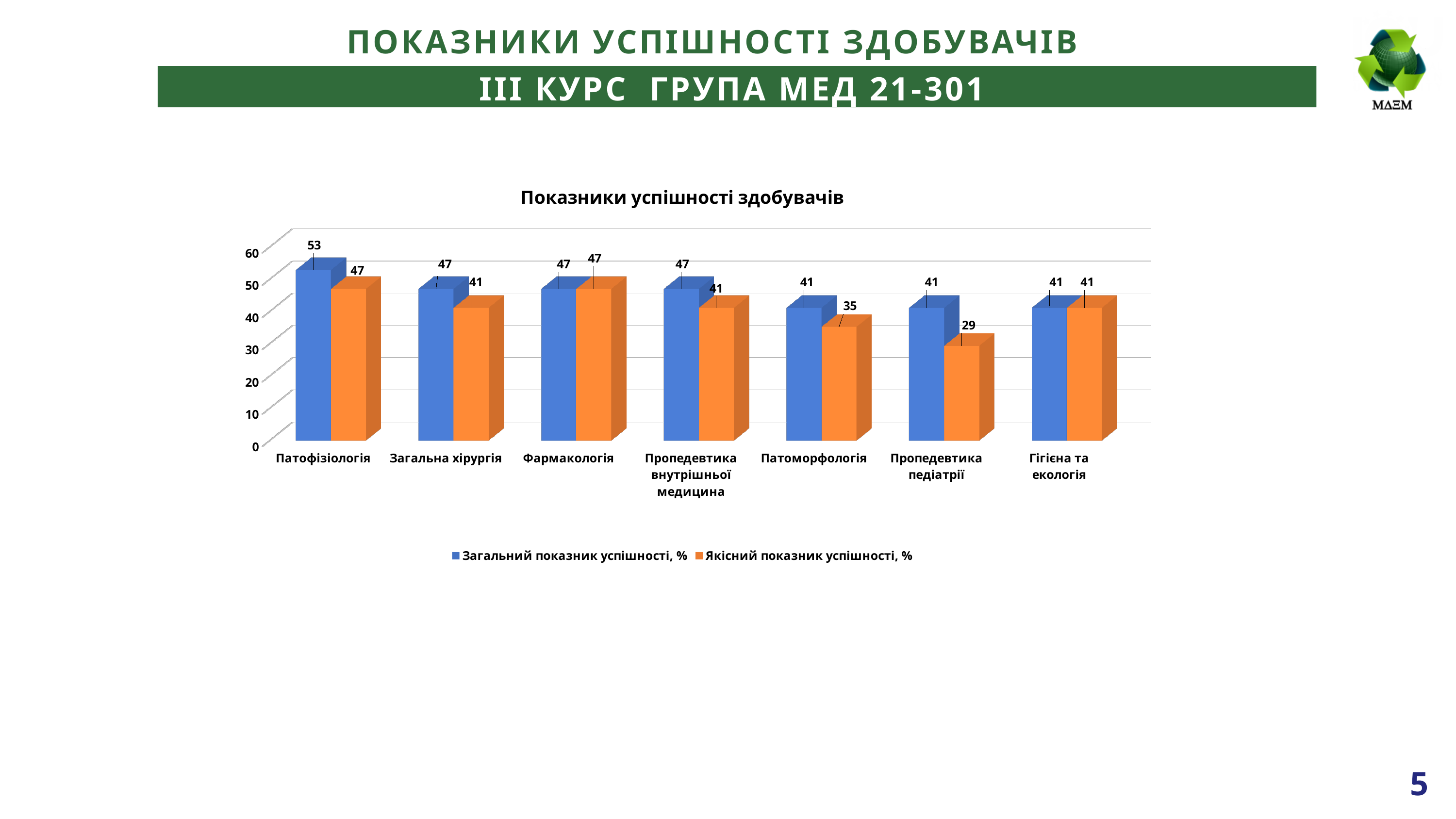
How many series does the legend list? 2 Which category has the lowest value for Якісний показник успішності, %? Пропедевтика педіатрії Which is larger for Загальна хірургія: Загальний показник успішності, % or Якісний показник успішності, %? Загальний показник успішності, % What kind of chart is shown on the slide? Bar chart What is the value of Загальний показник успішності, % for Патофізіологія? 53 What is the difference between Загальний показник успішності, % and Якісний показник успішності, % for Пропедевтика педіатрії? 12 What is the value of Якісний показник успішності, % for Пропедевтика педіатрії? 29 What is the value of Якісний показник успішності, % for Патоморфологія? 35 What is the title of the chart? Показники успішності здобувачів How many categories are shown on the x axis? 7 What is the difference between Загальний показник успішності, % and Якісний показник успішності, % for Патофізіологія? 6 Which category has the highest value for Загальний показник успішності, %? Патофізіологія